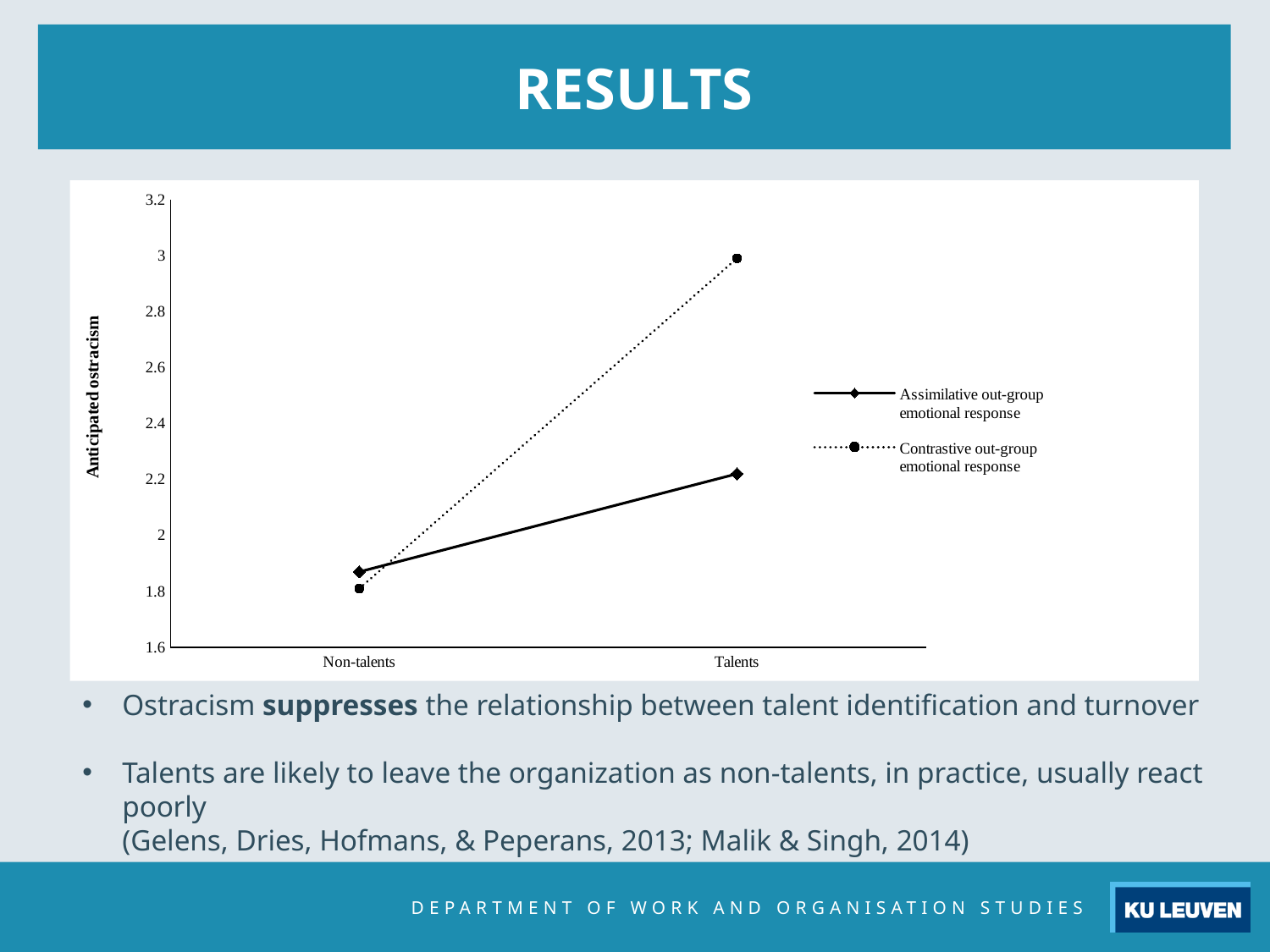
Do the values of the Contrastive out-group emotional response series rise or fall from Non-talents to Talents? rise At Talents, which series has the higher value, Assimilative out-group emotional response or Contrastive out-group emotional response? Contrastive out-group emotional response Is the value for Non-talents in the Contrastive out-group emotional response series greater or less than 2? less Which series is drawn with a dotted line? Contrastive out-group emotional response For the Assimilative out-group emotional response series, which category has the higher value? Talents What is the label of the y axis? Anticipated ostracism What kind of chart is shown on the slide? line chart How many series does the legend list? 2 Is the value for Talents in the Assimilative out-group emotional response series greater or less than 2.4? less How many categories are shown on the x axis? 2 Is the value for Talents in the Contrastive out-group emotional response series greater or less than 2.8? greater